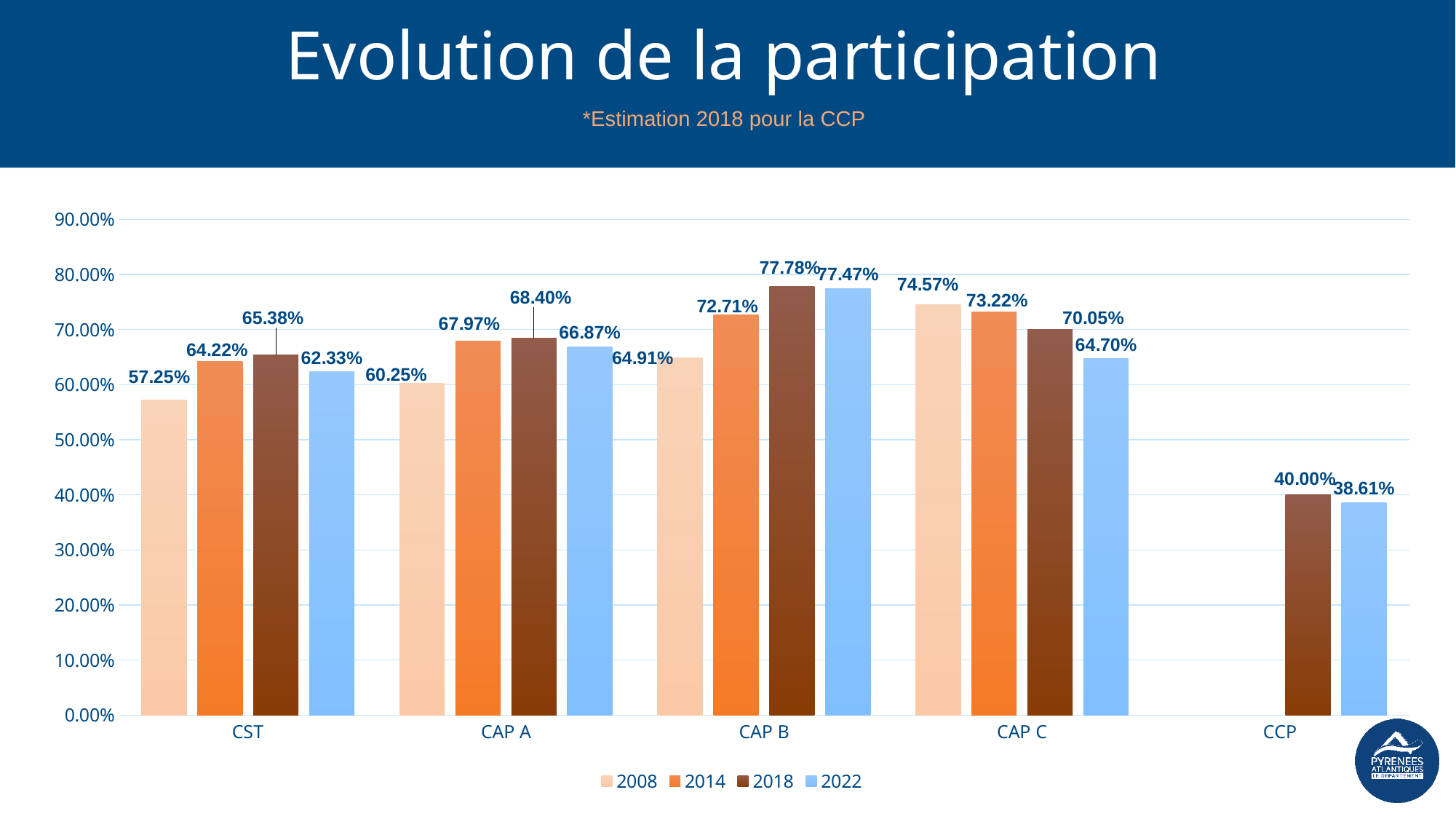
What kind of chart is shown on the slide? bar chart What is the value for CST in 2008? 57.25% What is the difference between the 2014 and 2008 values for CAP A? 7.72% What is the value for CAP B in 2018? 77.78% How many categories are shown on the x axis? 5 Which category has the lowest value for the 2022 series? CCP Do the values for CAP C rise or fall from 2008 to 2022? fall Which is larger for CAP C: the 2008 value or the 2022 value? 2008 Which category has the highest value for the 2008 series? CAP C How many series does the legend list? 4 What is the value for CCP in 2022? 38.61% What is the title of the chart? Evolution de la participation